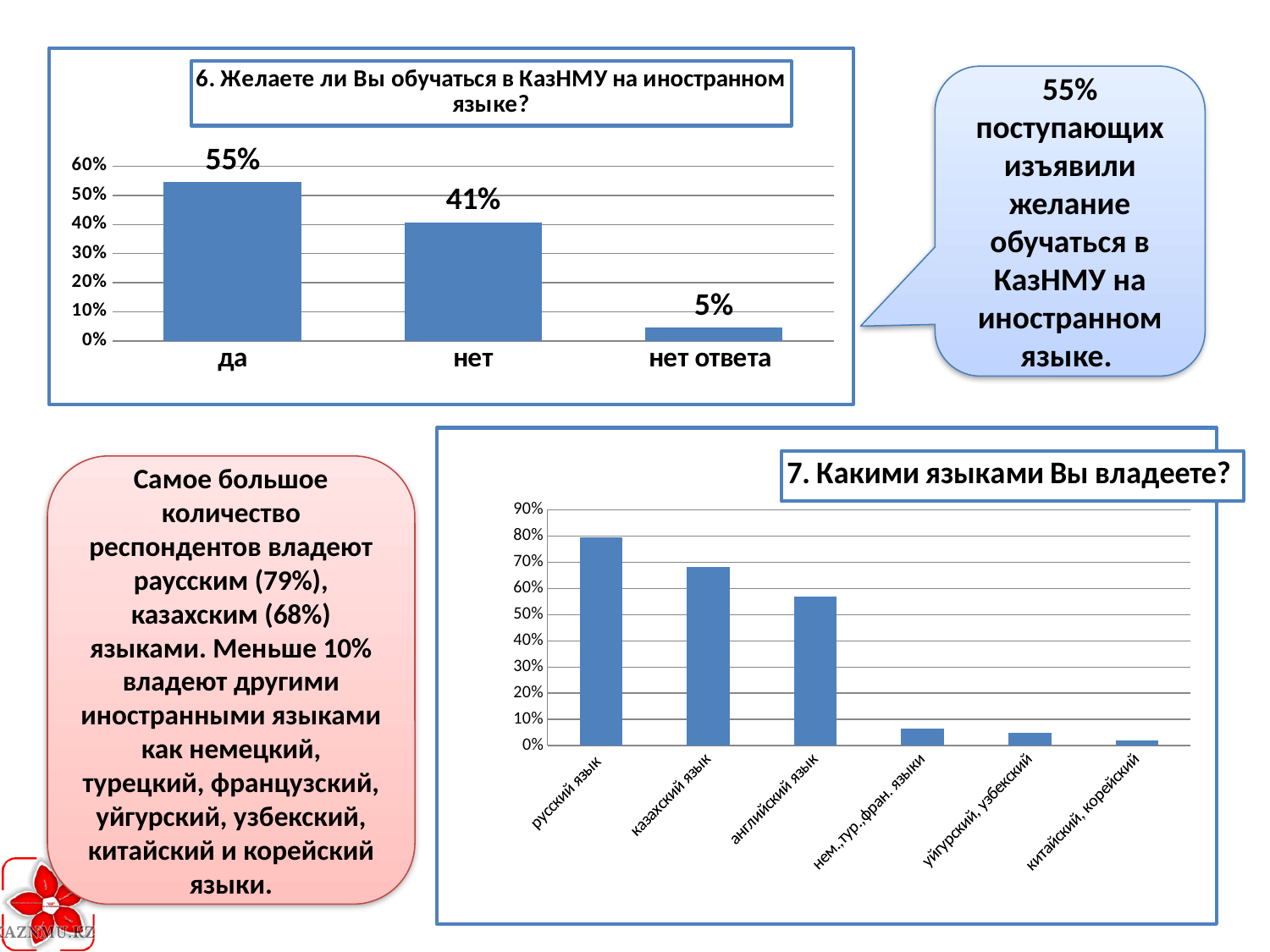
In the chart titled "6. Желаете ли Вы обучаться в КазНМУ на иностранном языке?", which category has the lowest value? нет ответа In the chart titled "7. Какими языками Вы владеете?", which category has the lowest value? китайский, корейский In the chart titled "7. Какими языками Вы владеете?", how many categories are shown? 6 In the chart titled "6. Желаете ли Вы обучаться в КазНМУ на иностранном языке?", what is the value for "да"? 55% In the chart titled "6. Желаете ли Вы обучаться в КазНМУ на иностранном языке?", what is the value for "нет"? 41% In the chart titled "7. Какими языками Вы владеете?", which category has the highest value? русский язык In the chart titled "7. Какими языками Вы владеете?", is the value for "уйгурский, узбекский" greater or less than 10%? less In the chart titled "7. Какими языками Вы владеете?", is the value for "английский язык" greater or less than 50%? greater In the chart titled "6. Желаете ли Вы обучаться в КазНМУ на иностранном языке?", what is the value for "нет ответа"? 5% In the chart titled "6. Желаете ли Вы обучаться в КазНМУ на иностранном языке?", how many categories are shown? 3 In the chart titled "7. Какими языками Вы владеете?", which is larger, the value for "казахский язык" or the value for "английский язык"? казахский язык In the chart titled "6. Желаете ли Вы обучаться в КазНМУ на иностранном языке?", what is the difference between the values for "да" and "нет"? 14%